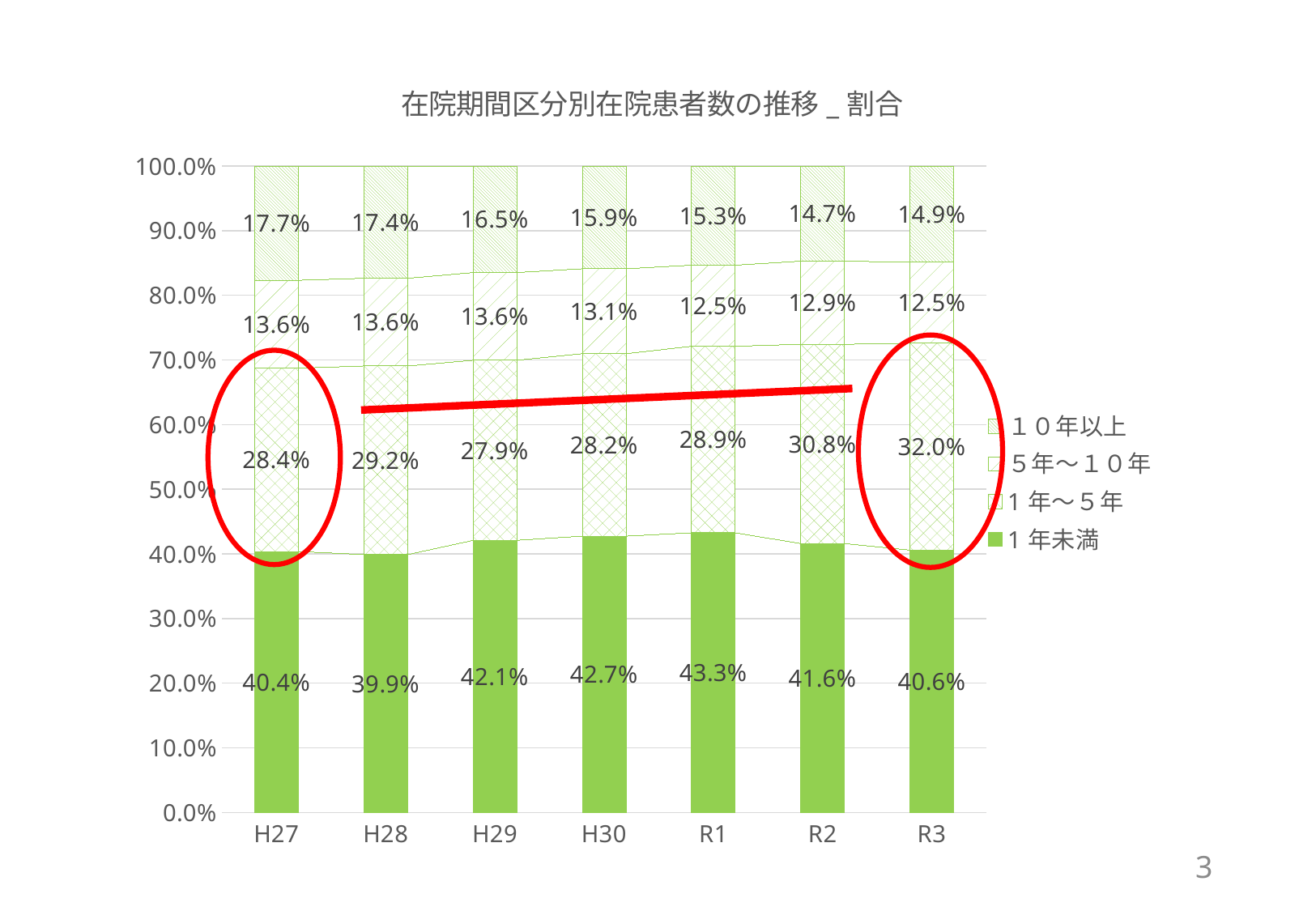
In which year is the 10年以上 share lowest? R2 Does the 10年以上 share generally rise or fall from H27 to R3? Fall In which year is the 1年未満 share highest? R1 Which is larger, the 1年未満 value at H30 or at R2? H30 What is the value for 5年～10年 at R1? 12.5% What is the value for 1年未満 at H27? 40.4% What is the value for 1年～5年 at R3? 32.0% What kind of chart is this? Stacked bar chart How many series does the legend list? 4 How many years are shown on the x axis? 7 What is the value for 10年以上 at H29? 16.5% What is the difference between the 1年～5年 values at R3 and H27? 3.6%